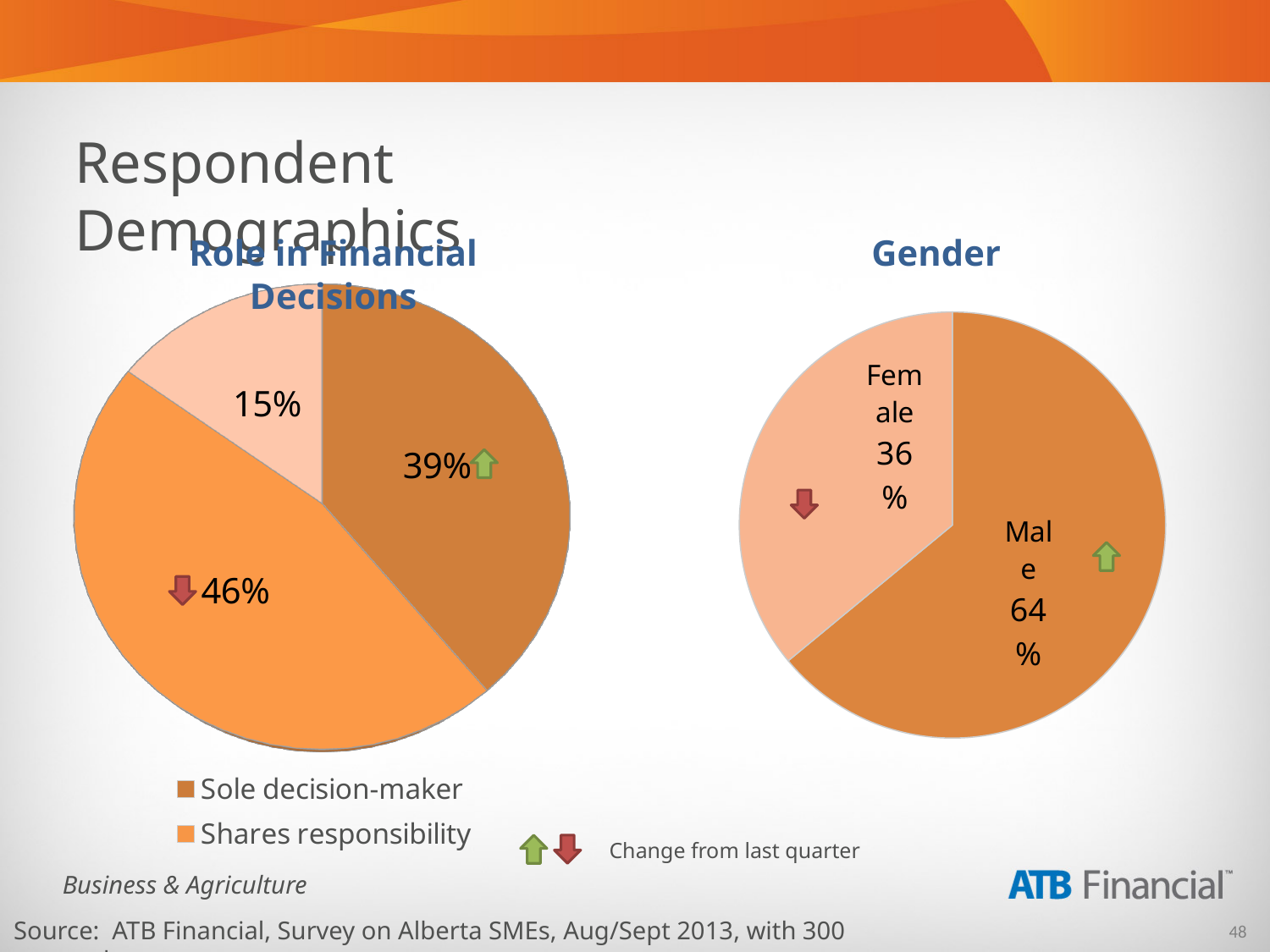
How many slices does the Role in Financial Decisions chart have? 3 In the Gender chart, which slice is the smallest? Female In the Role in Financial Decisions chart, which slice is the largest? Shares responsibility In the Role in Financial Decisions chart, what share of respondents share responsibility? 46% In the Role in Financial Decisions chart, which is larger: Sole decision-maker or Shares responsibility? Shares responsibility In the Gender chart, what percentage of respondents are female? 36% In the Role in Financial Decisions chart, what is the difference in percentage points between Shares responsibility and Sole decision-maker? 7 What type of chart is the Gender chart? Pie chart In the Role in Financial Decisions chart, what share of respondents are sole decision-makers? 39% In the Gender chart, what percentage of respondents are male? 64% In the Gender chart, what is the difference in percentage points between Male and Female? 28 In the Gender chart, which slice shows an increase from last quarter? Male